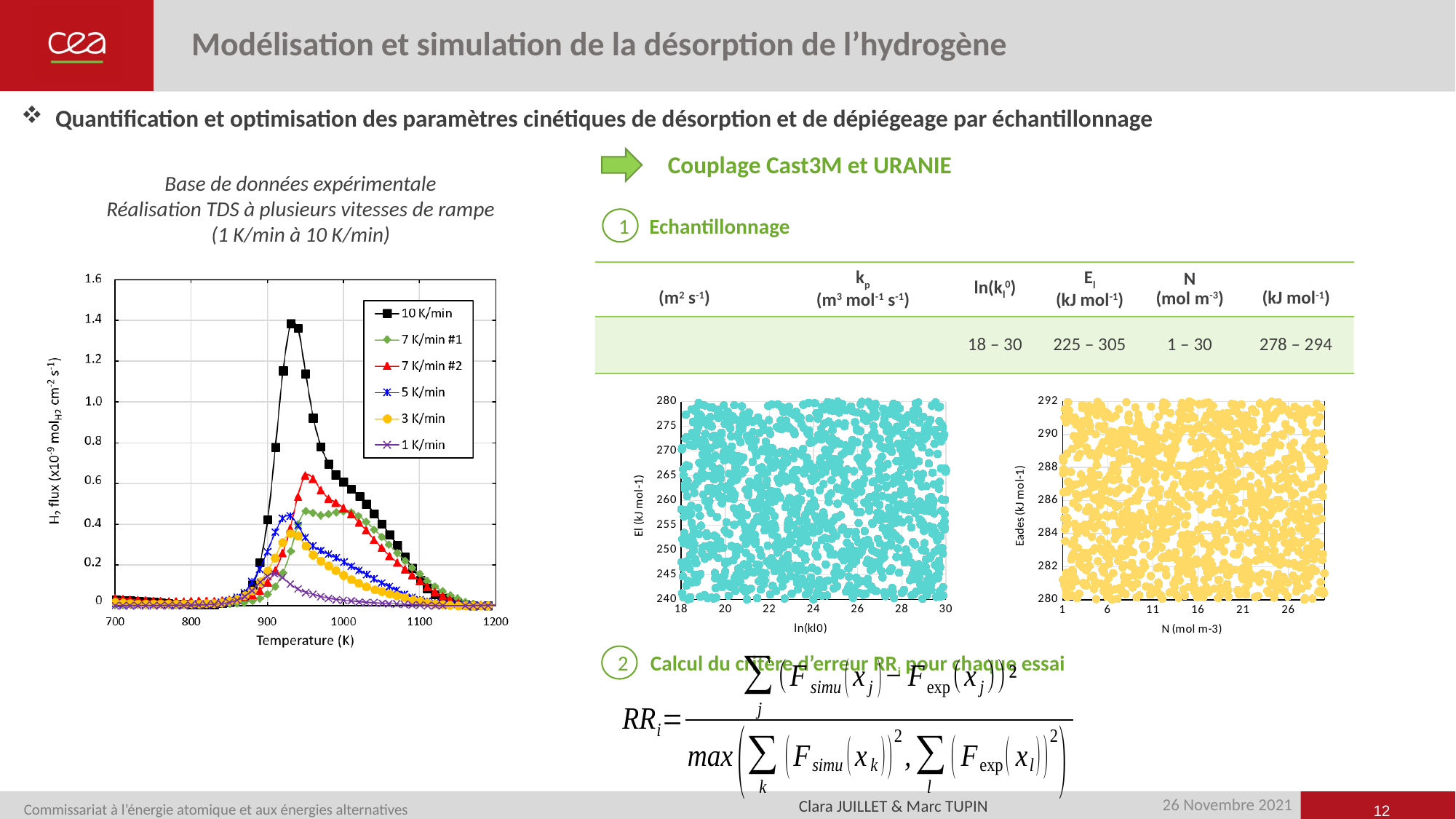
What is the x-axis label of the yellow scatter chart on the right of the slide? N (mol m-3) What is the x-axis label of the left-hand H2 flux chart? Temperature (K) What kind of chart is the left-hand chart showing H2 flux versus Temperature (K)? line chart In the left-hand H2 flux chart, which series has the lowest peak? 1 K/min In the left-hand H2 flux chart, how many series does the legend list? 6 What kind of chart is the cyan chart plotting El (kJ mol-1) against ln(kl0)? scatter chart In the left-hand H2 flux chart, does the 10 K/min curve rise or fall between 1000 K and 1100 K? fall In the left-hand H2 flux chart, is the peak value of the 5 K/min series greater or less than 0.6? less In the left-hand H2 flux chart, which series reaches the highest peak? 10 K/min In the left-hand H2 flux chart, is the peak value of the 7 K/min #2 series greater or less than 0.8? less In the left-hand H2 flux chart, which series has the higher peak: 3 K/min or 1 K/min? 3 K/min In the left-hand H2 flux chart, is the peak value of the 10 K/min series greater or less than 1.2? greater